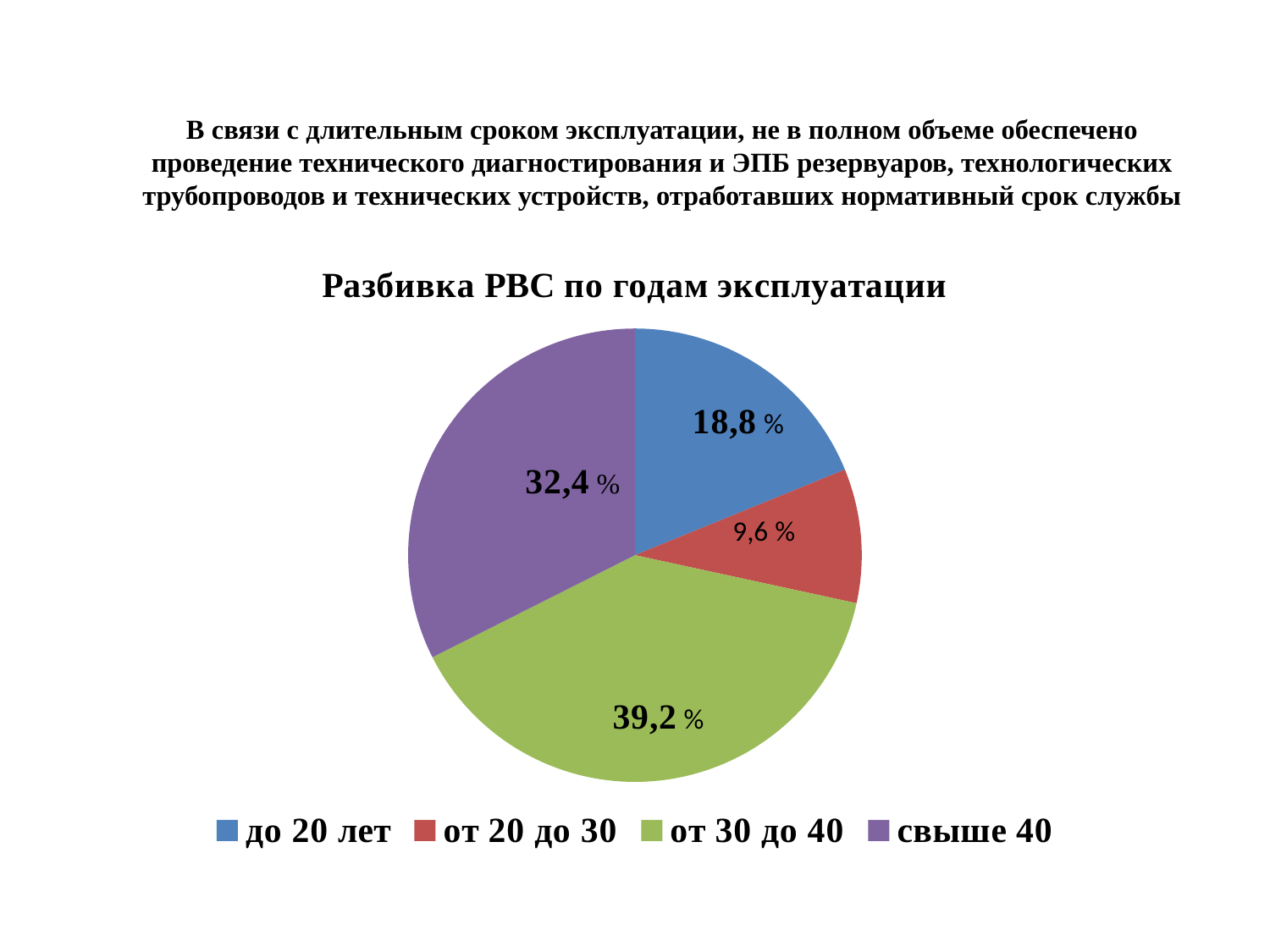
What is the value shown for 'от 20 до 30'? 9,6 % What is the difference between the 'от 30 до 40' and 'свыше 40' slices? 6,8 % What share of the pie does the 'до 20 лет' slice have? 18,8 % What is the title of the chart? Разбивка РВС по годам эксплуатации Which category has the smallest slice of the pie? от 20 до 30 Which is larger, the slice for 'свыше 40' or the slice for 'до 20 лет'? свыше 40 What colour is the 'от 30 до 40' slice? green How many categories does the pie chart have? 4 What type of chart is shown on the slide? pie chart What is the value shown for 'от 30 до 40'? 39,2 % Which category has the largest slice of the pie? от 30 до 40 What is the value shown for 'свыше 40'? 32,4 %